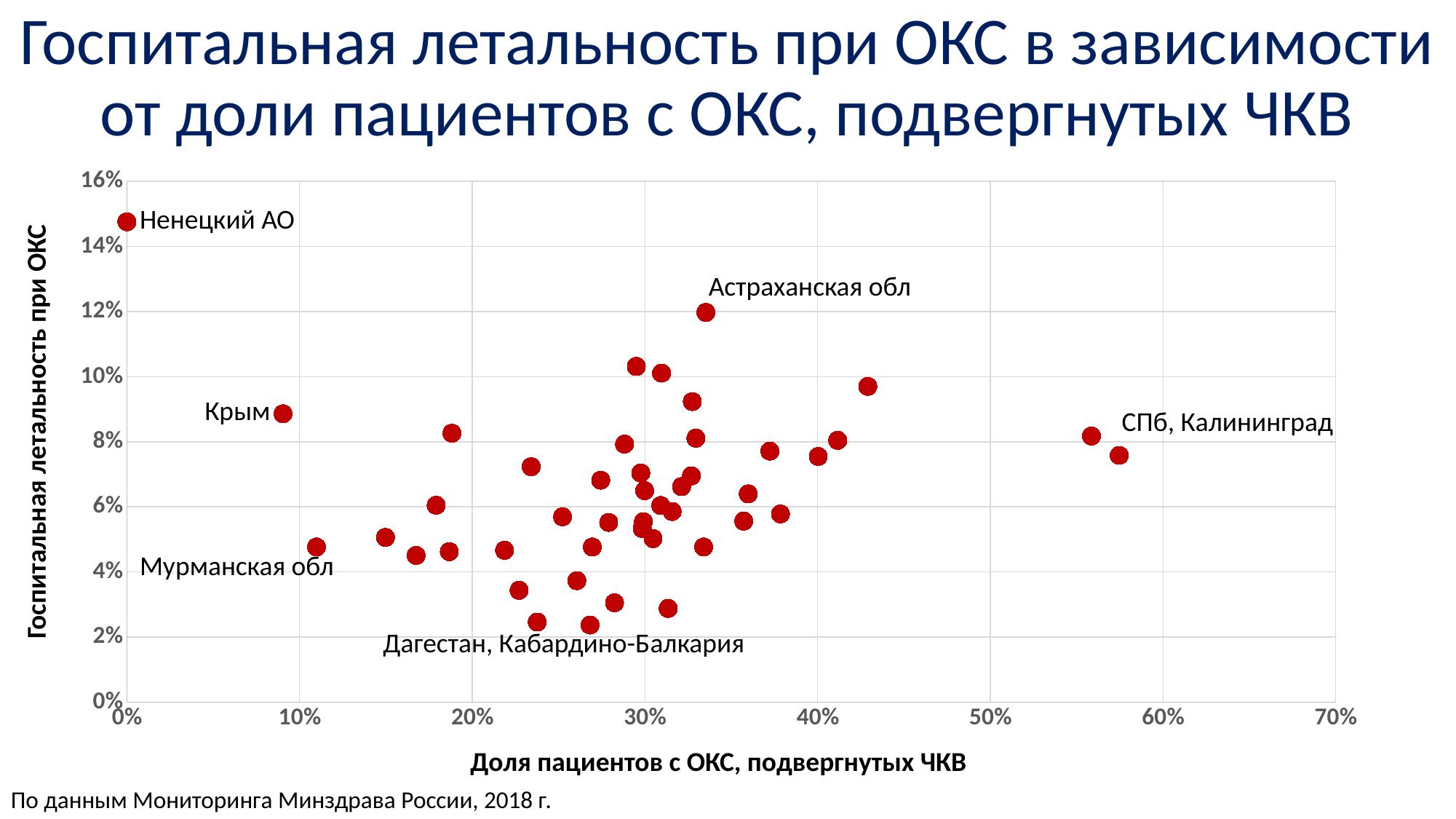
Is the hospital mortality for Ненецкий АО greater or less than 14%? greater Is the share of patients undergoing ЧКВ for СПб, Калининград greater or less than 50%? greater Is the hospital mortality for Астраханская обл greater or less than 10%? greater Which labelled regions have the highest share of patients with ОКС undergoing ЧКВ? СПб, Калининград Which labelled regions have the lowest hospital mortality on the chart? Дагестан, Кабардино-Балкария Which labelled region has the highest hospital mortality (Госпитальная летальность при ОКС)? Ненецкий АО What is the maximum value shown on the vertical axis? 16% Which has higher hospital mortality, Крым or Мурманская обл? Крым What is the title of the horizontal axis? Доля пациентов с ОКС, подвергнутых ЧКВ What kind of chart is shown on the slide? scatter chart